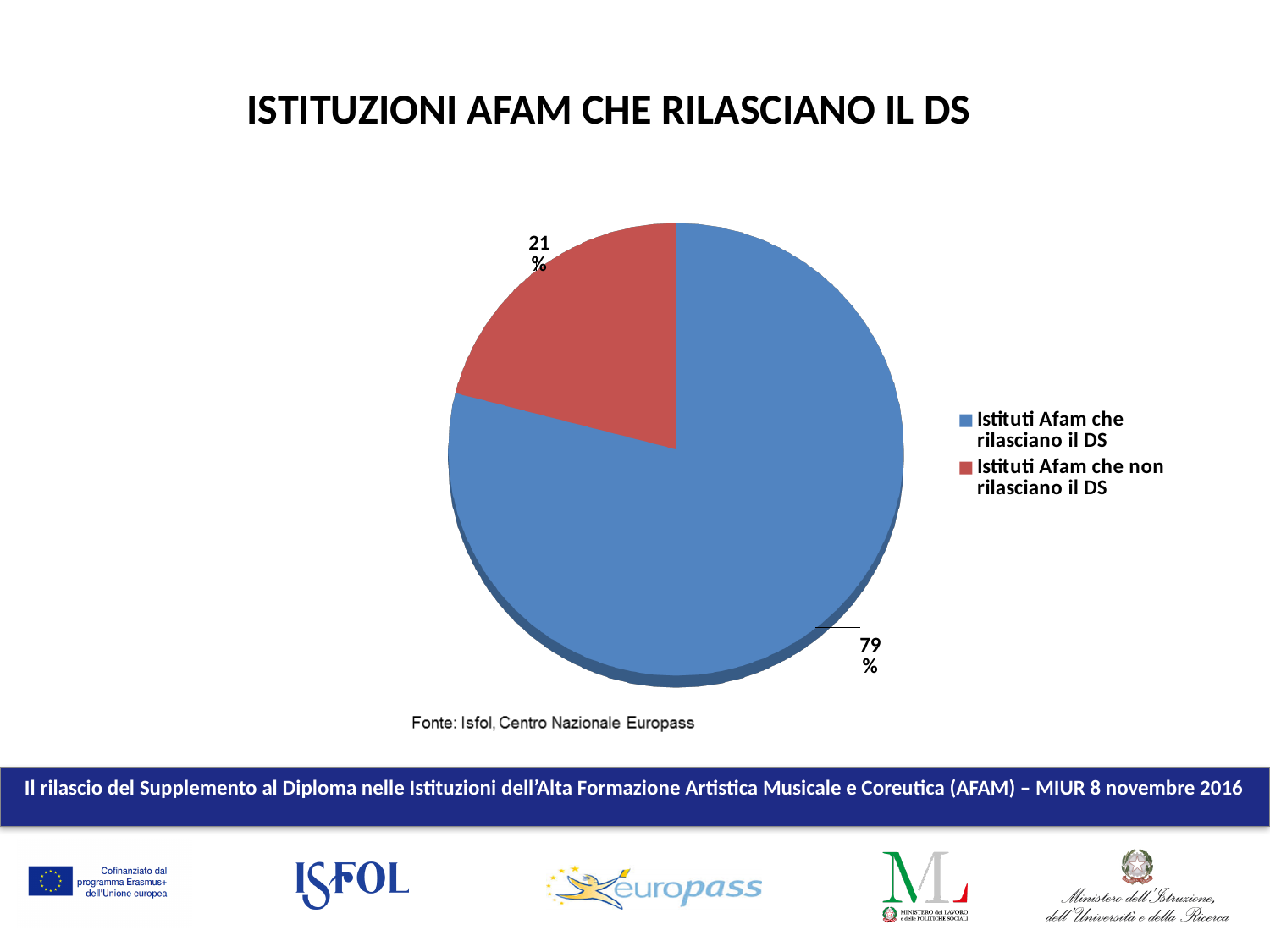
What colour is the slice for 'Istituti Afam che non rilasciano il DS'? red How many entries does the legend list? 2 Which category has the largest slice of the pie? Istituti Afam che rilasciano il DS What is the difference in percentage points between the two slices? 58 What share of the pie is labelled for 'Istituti Afam che rilasciano il DS'? 79% Which slice is larger: 'Istituti Afam che rilasciano il DS' or 'Istituti Afam che non rilasciano il DS'? Istituti Afam che rilasciano il DS Which category has the smallest slice of the pie? Istituti Afam che non rilasciano il DS Is the share for 'Istituti Afam che rilasciano il DS' greater or less than 50%? greater How many slices does the pie chart have? 2 What kind of chart is shown on the slide? pie chart What is the title of the chart? ISTITUZIONI AFAM CHE RILASCIANO IL DS What share of the pie is labelled for 'Istituti Afam che non rilasciano il DS'? 21%